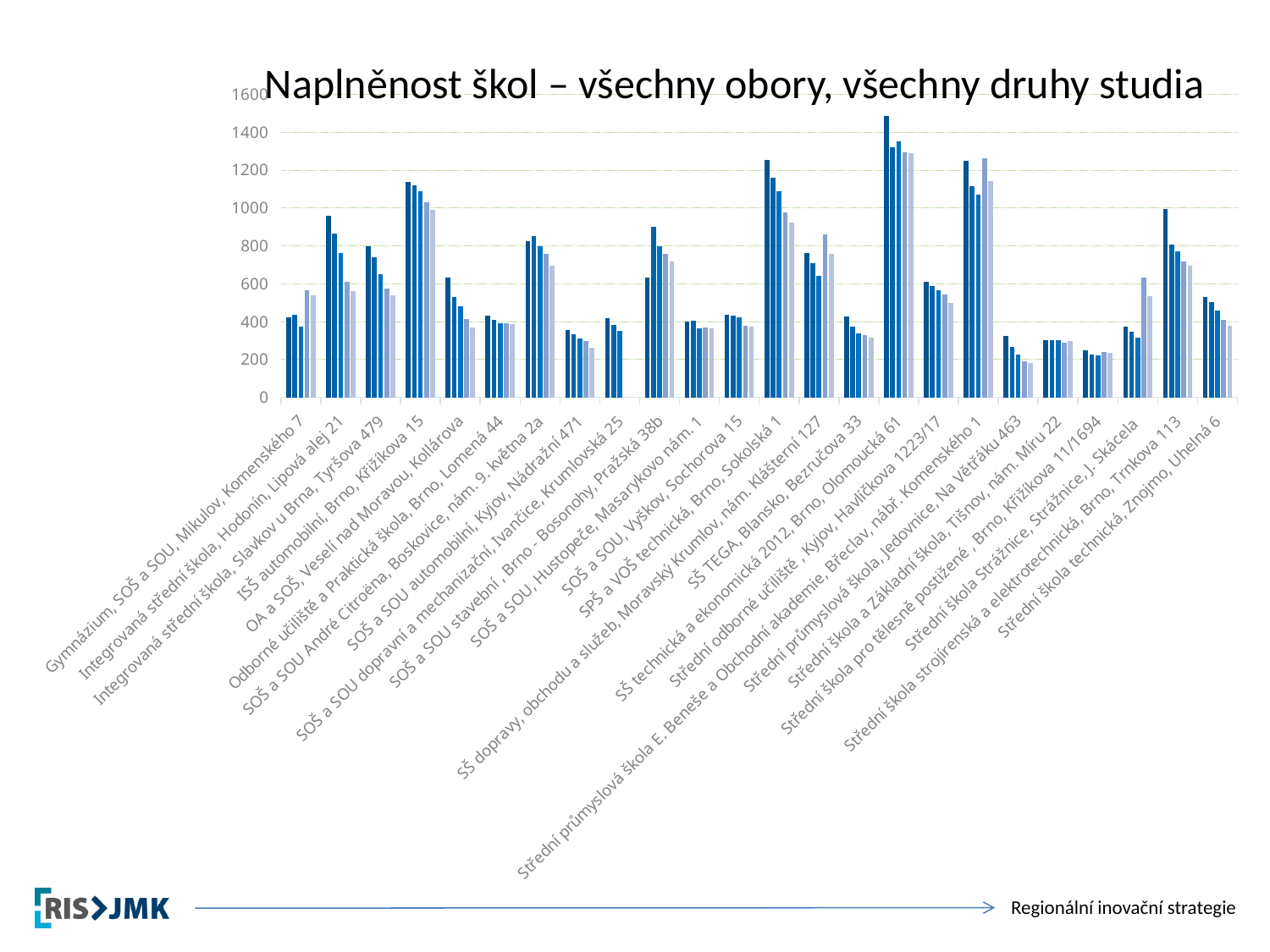
What kind of chart is shown on the slide? bar chart Is the tallest bar for Gymnázium, SOŠ a SOU, Mikulov, Komenského 7 greater or less than 600? less Which school has the tallest bar in the chart? SŠ technická a ekonomická 2012, Brno, Olomoucká 61 What is the maximum value shown on the vertical axis of the chart? 1600 Is the tallest bar for SPŠ a VOŠ technická, Brno, Sokolská 1 greater or less than 1200? greater Is the tallest bar for SŠ technická a ekonomická 2012, Brno, Olomoucká 61 greater or less than 1400? greater What is the title of the chart? Naplněnost škol – všechny obory, všechny druhy studia How many schools (categories) are shown on the x axis of the chart? 24 How many bars are plotted for each school in the chart? 5 Which school has higher bars: SŠ technická a ekonomická 2012, Brno, Olomoucká 61 or SPŠ a VOŠ technická, Brno, Sokolská 1? SŠ technická a ekonomická 2012, Brno, Olomoucká 61